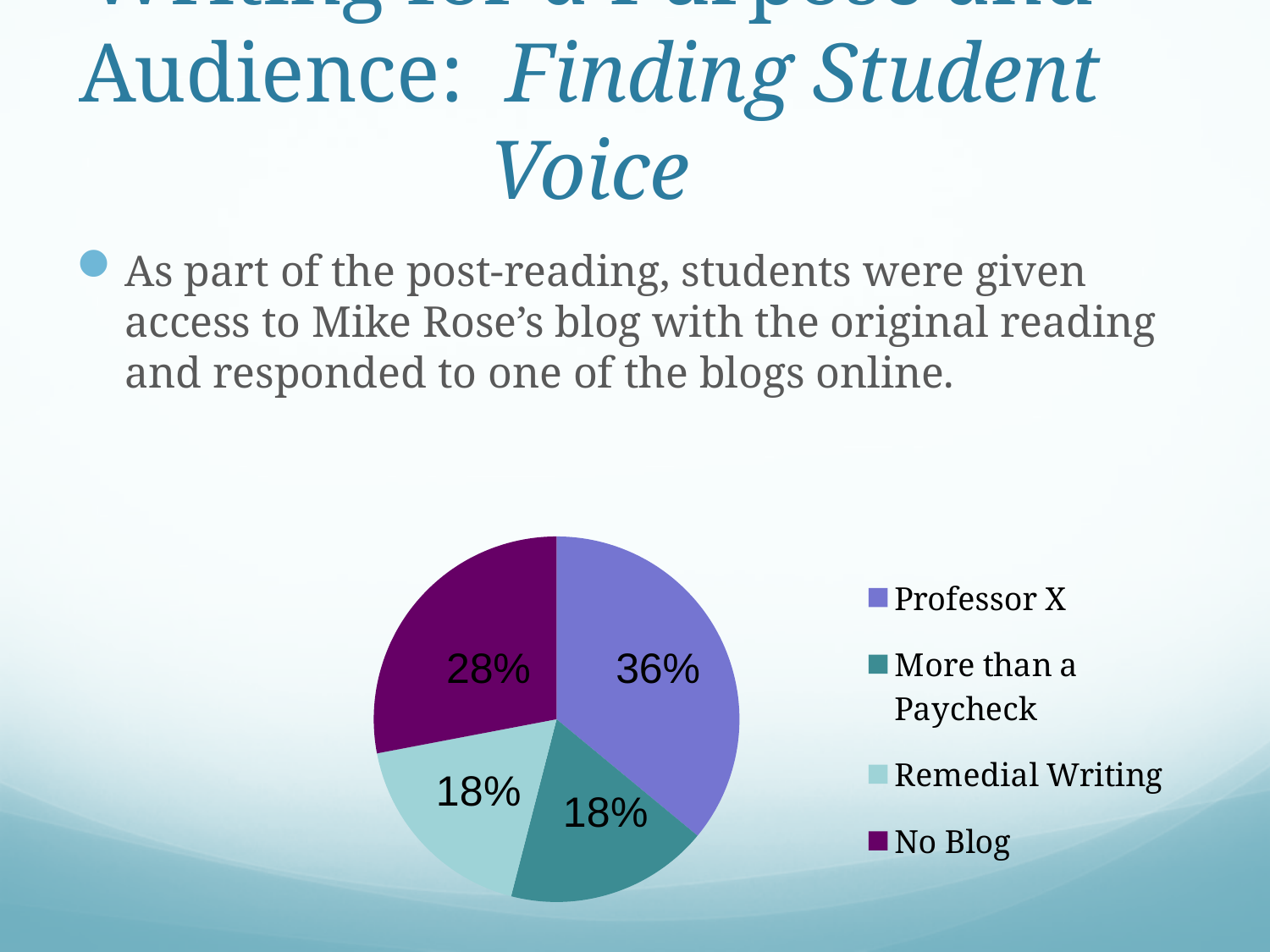
What is the difference in percentage points between Professor X and No Blog? 8 How many slices does the pie chart have? 4 What percentage of the pie chart is No Blog? 28% What percentage of the pie chart is More than a Paycheck? 18% Which legend entry is shown in the darkest purple colour? No Blog Which is larger in the pie chart, No Blog or Remedial Writing? No Blog Which category has the largest slice of the pie chart? Professor X What percentage of the pie chart is Professor X? 36% What is the combined share of More than a Paycheck and Remedial Writing? 36% What kind of chart is shown on the slide? pie chart How many entries does the legend of the pie chart list? 4 What percentage of the pie chart is Remedial Writing? 18%